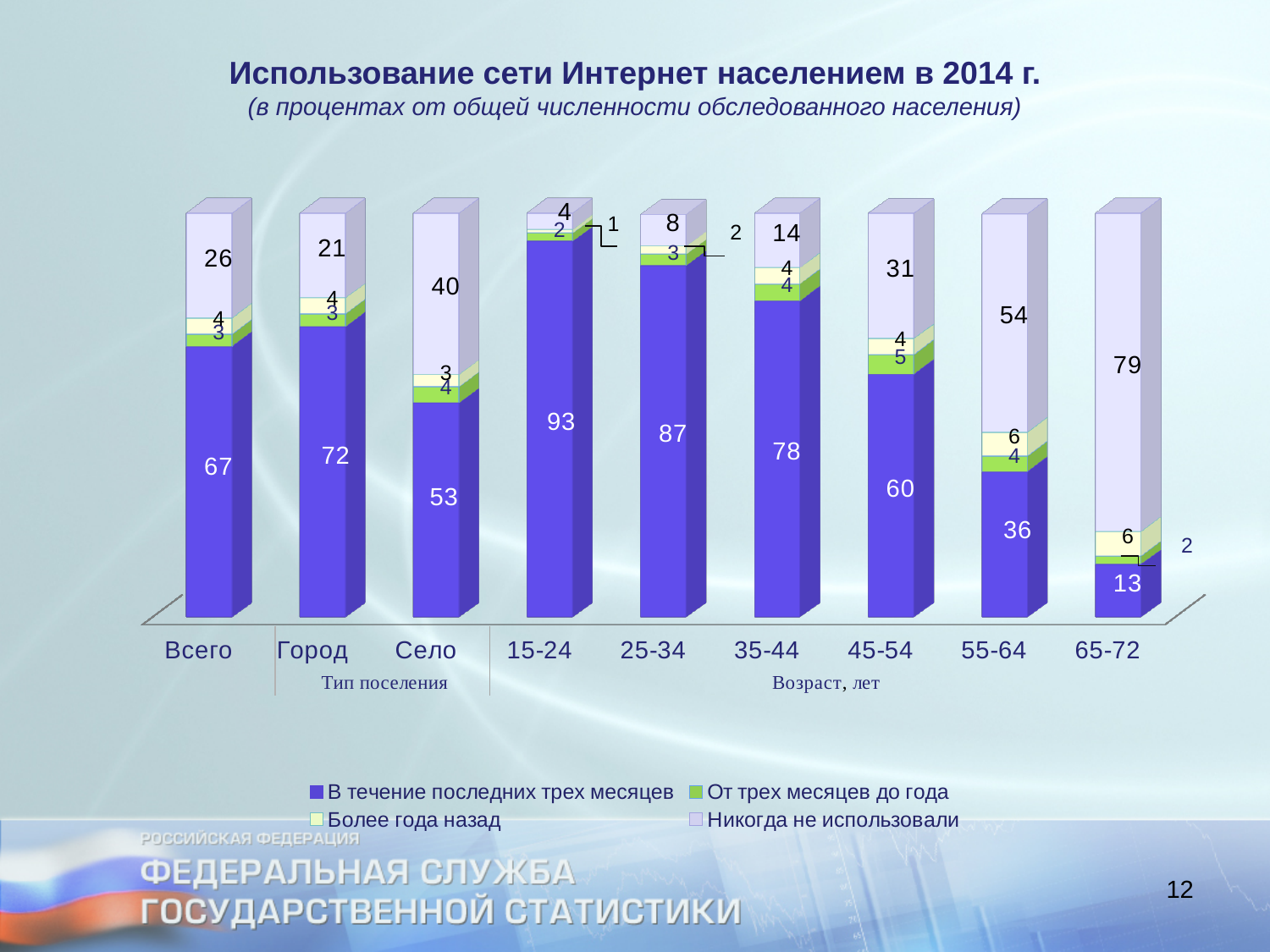
Which category has the lowest value for 'Никогда не использовали'? 15-24 What is the value of 'В течение последних трех месяцев' for the 'Всего' category? 67 What is the value of 'Более года назад' for the 55-64 age group? 6 Which is larger: the 'Никогда не использовали' value for 45-54 or for 55-64? 55-64 What is the value of 'Никогда не использовали' for the 'Село' category? 40 Across the age groups from 15-24 to 65-72, does the 'В течение последних трех месяцев' value rise or fall? Fall How many series does the legend list? 4 What kind of chart is shown on the slide? Stacked bar chart How many categories are shown on the x axis? 9 What is the value of 'В течение последних трех месяцев' for the 65-72 age group? 13 What is the difference between the 'В течение последних трех месяцев' values for 'Город' and 'Село'? 19 Which category has the highest value for 'В течение последних трех месяцев'? 15-24